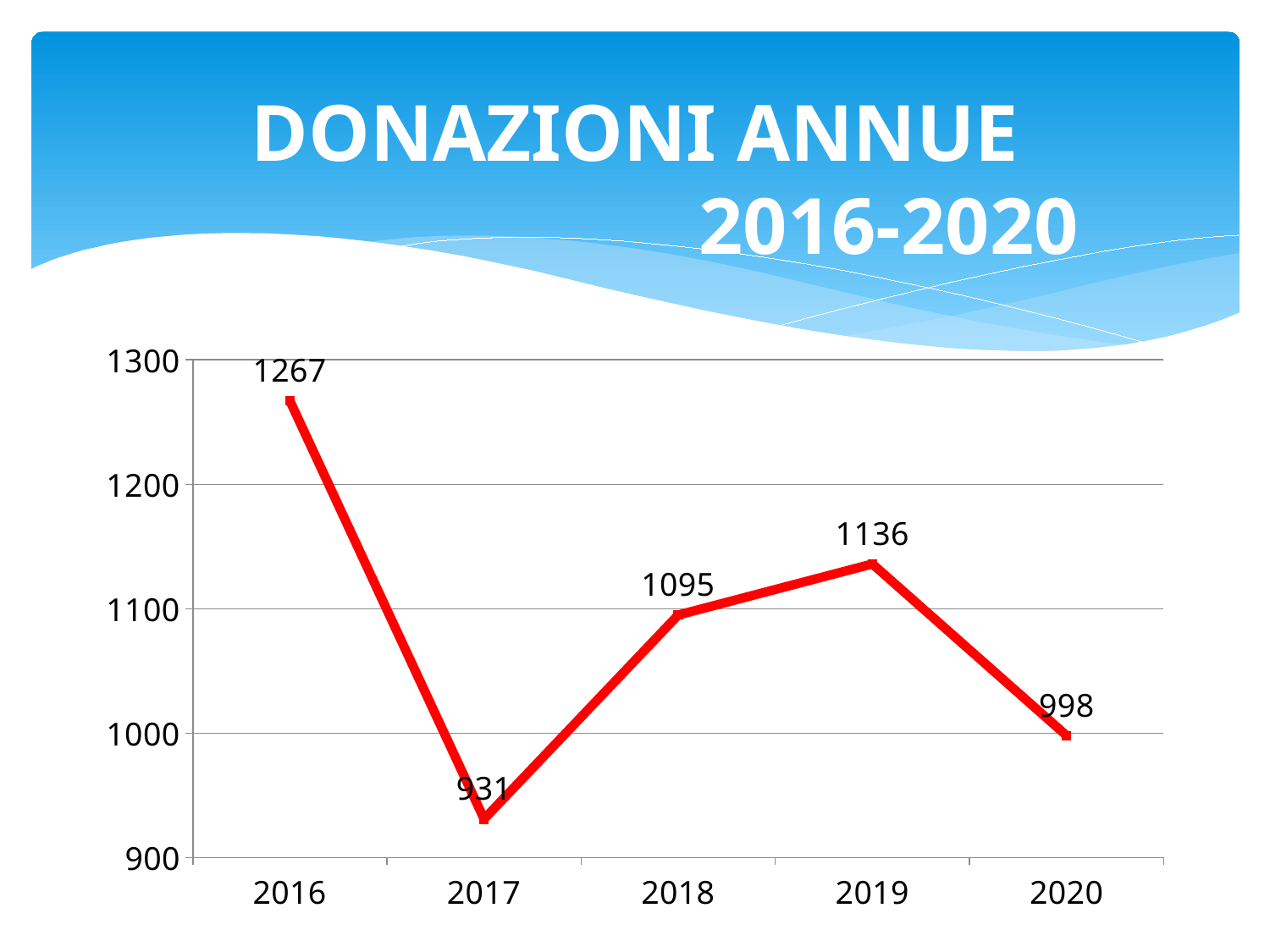
What is the difference between the values for 2016 and 2017? 336 Which year has the lowest value? 2017 What is the value for 2017? 931 What is the value for 2016? 1267 What is the value for 2020? 998 What is the difference between the values for 2019 and 2018? 41 Which year has the highest value? 2016 How many years are plotted on the chart? 5 What kind of chart is shown on the slide? line chart What is the title of the slide? DONAZIONI ANNUE 2016-2020 Which is larger, the value for 2018 or the value for 2020? 2018 What is the value for 2019? 1136